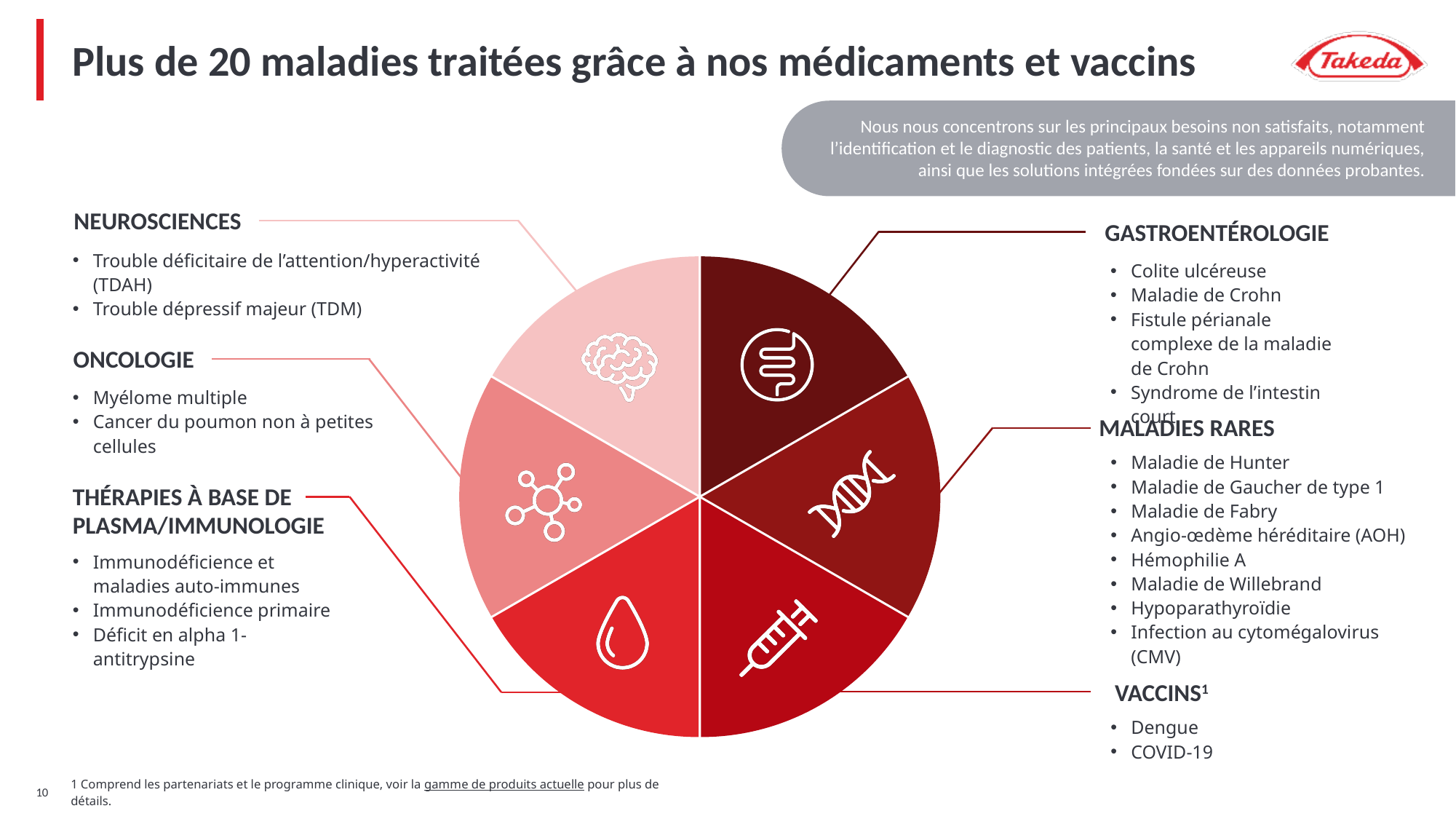
How many slices does the pie chart have? 6 How many diseases are listed under MALADIES RARES? 8 Which therapeutic area is linked to the slice with the brain icon? NEUROSCIENCES Which therapeutic area is linked to the slice with the syringe icon? VACCINS How many diseases are listed under ONCOLOGIE? 2 Which therapeutic area lists the most diseases? MALADIES RARES Which therapeutic area lists more diseases, MALADIES RARES or NEUROSCIENCES? MALADIES RARES What kind of chart is shown on the slide? pie chart